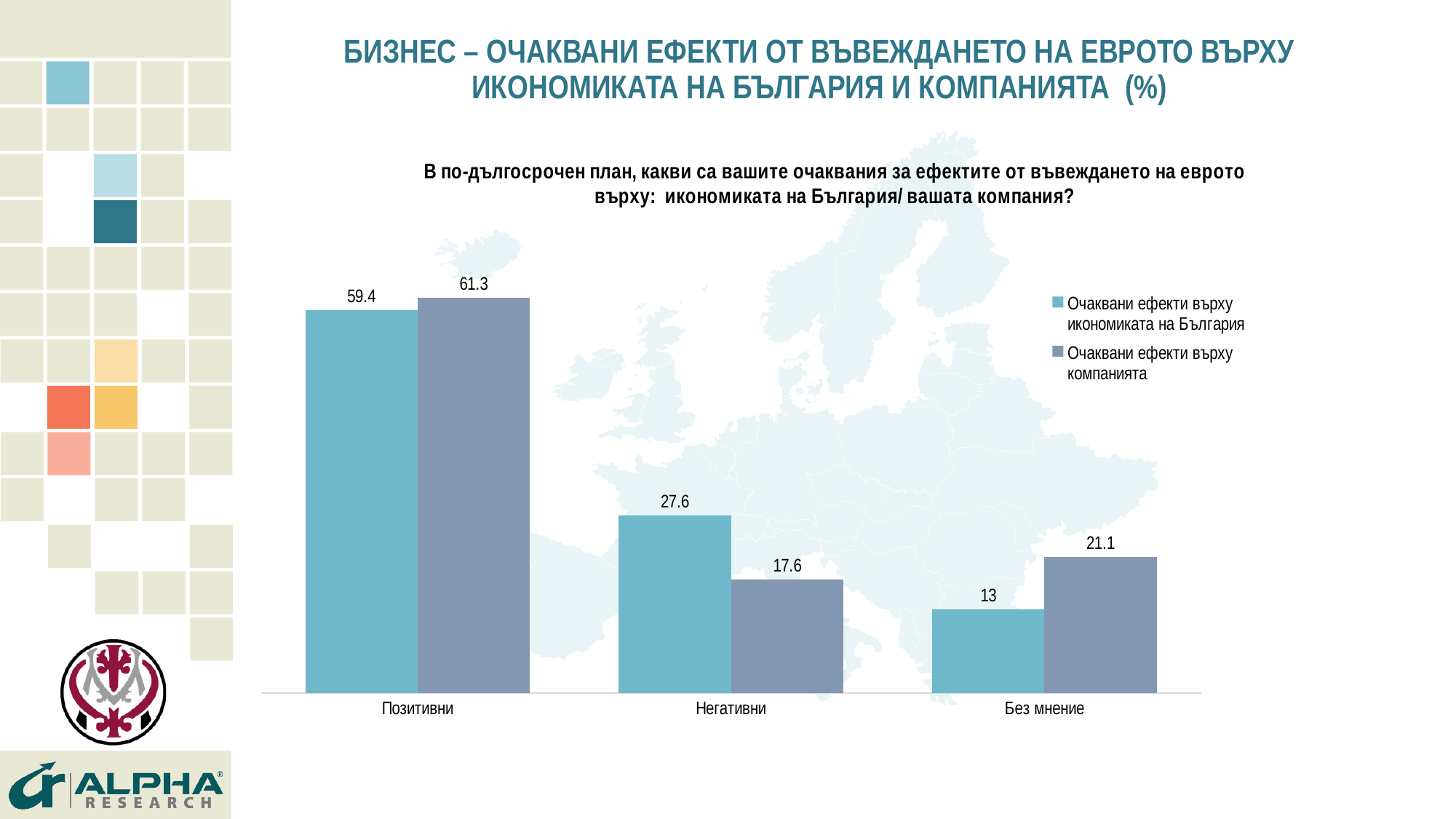
Which category has the highest value in the series Очаквани ефекти върху компанията? Позитивни Which category has the lowest value in the series Очаквани ефекти върху икономиката на България? Без мнение How many categories are shown on the x axis? 3 What kind of chart is shown on the slide? Bar chart What is the value for Позитивни in the series Очаквани ефекти върху икономиката на България? 59.4 How many series does the legend list? 2 What is the difference between the two series' values for Негативни? 10 What is the difference between the two series' values for Позитивни? 1.9 What is the value for Позитивни in the series Очаквани ефекти върху компанията? 61.3 For Без мнение, which series has the larger value? Очаквани ефекти върху компанията What is the value for Негативни in the series Очаквани ефекти върху икономиката на България? 27.6 What is the value for Без мнение in the series Очаквани ефекти върху компанията? 21.1